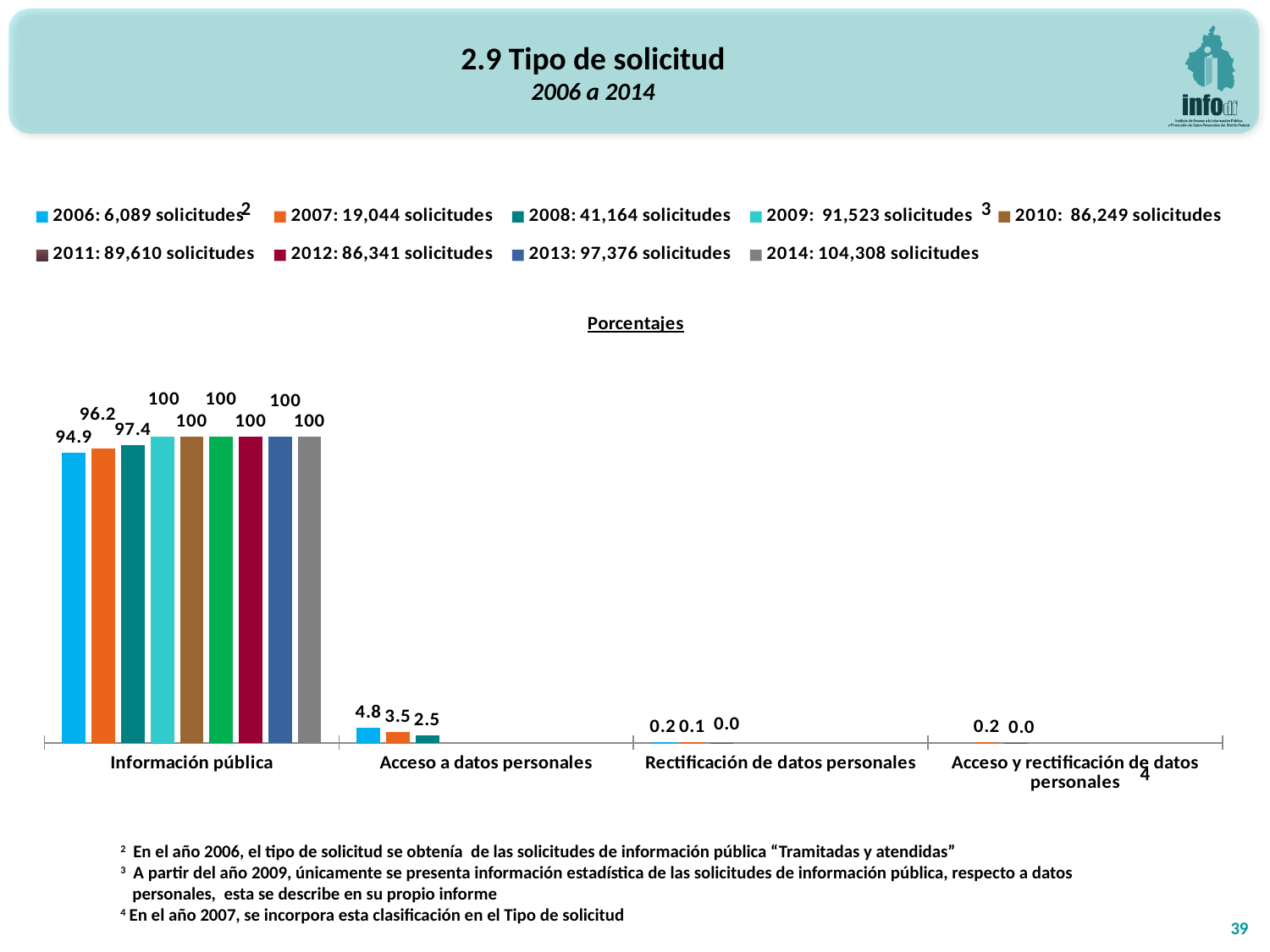
What is the difference between the 2008 and 2006 values in the Información pública category? 2.5 How many categories are shown on the x axis? 4 Which is larger in the Acceso a datos personales category, the 2006 value or the 2007 value? 2006 What is the value for 2006 in the Acceso a datos personales category? 4.8 What is the value for 2008 in the Acceso a datos personales category? 2.5 What is the value for 2006 in the Información pública category? 94.9 What is the value for 2007 in the Información pública category? 96.2 How many series does the legend list? 9 What is the subtitle printed above the chart area? Porcentajes Which year has the lowest value in the Información pública category? 2006 What kind of chart is shown on the slide? bar chart Do the values for Información pública rise or fall from 2006 to 2008? rise